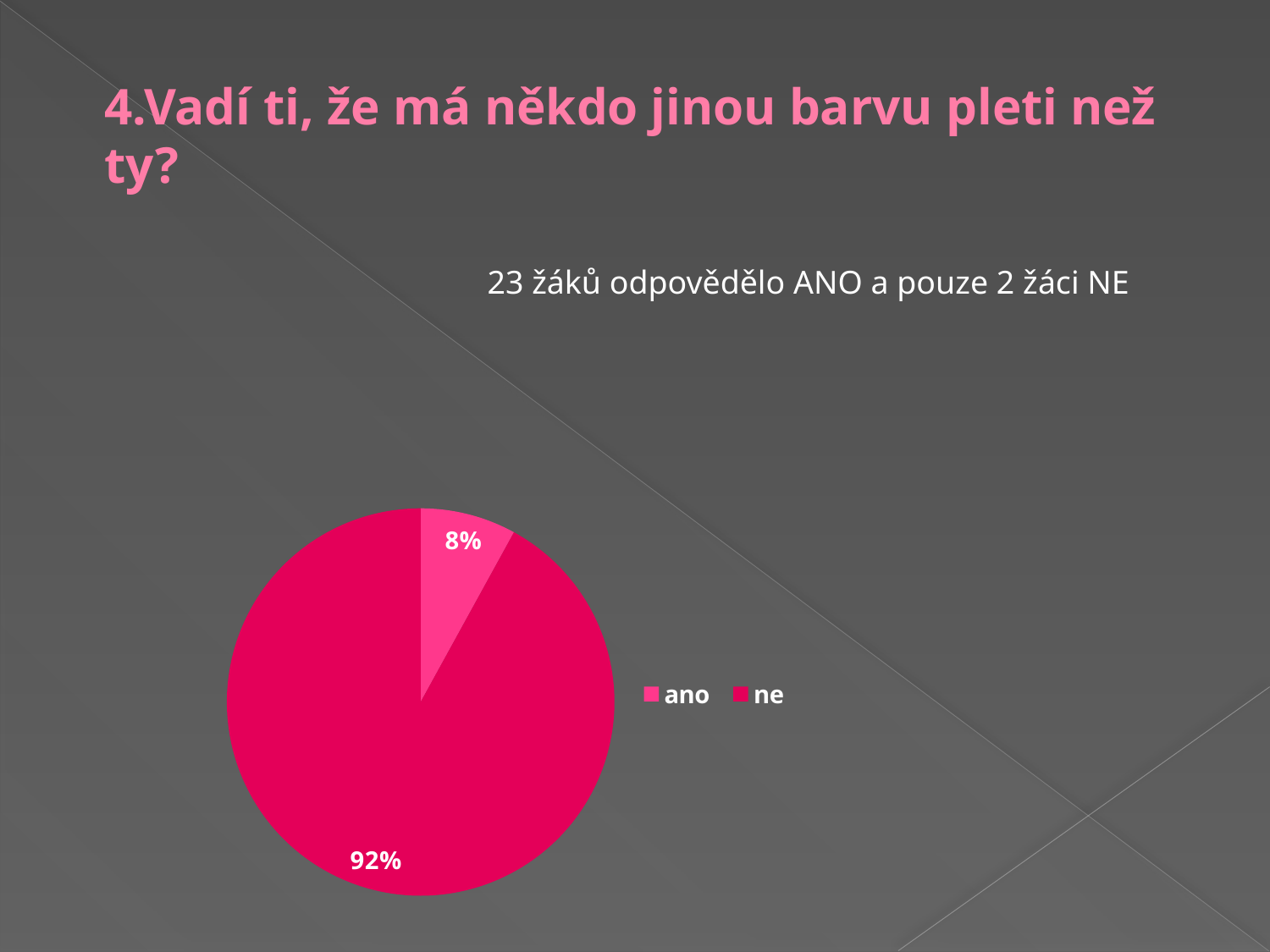
How many entries does the legend list? 2 Is the share of the "ne" slice greater or less than 50%? greater What is the total of the two percentages shown on the pie chart? 100% Which is larger, the "ano" slice or the "ne" slice? ne What share of the pie does the "ano" slice represent? 8% What is the difference in percentage points between the "ne" slice and the "ano" slice? 84 Which slice of the pie chart is the largest? ne What share of the pie does the "ne" slice represent? 92% What kind of chart is shown on the slide? pie chart What are the two legend entries of the pie chart? ano, ne Which slice of the pie chart is the smallest? ano How many slices does the pie chart have? 2